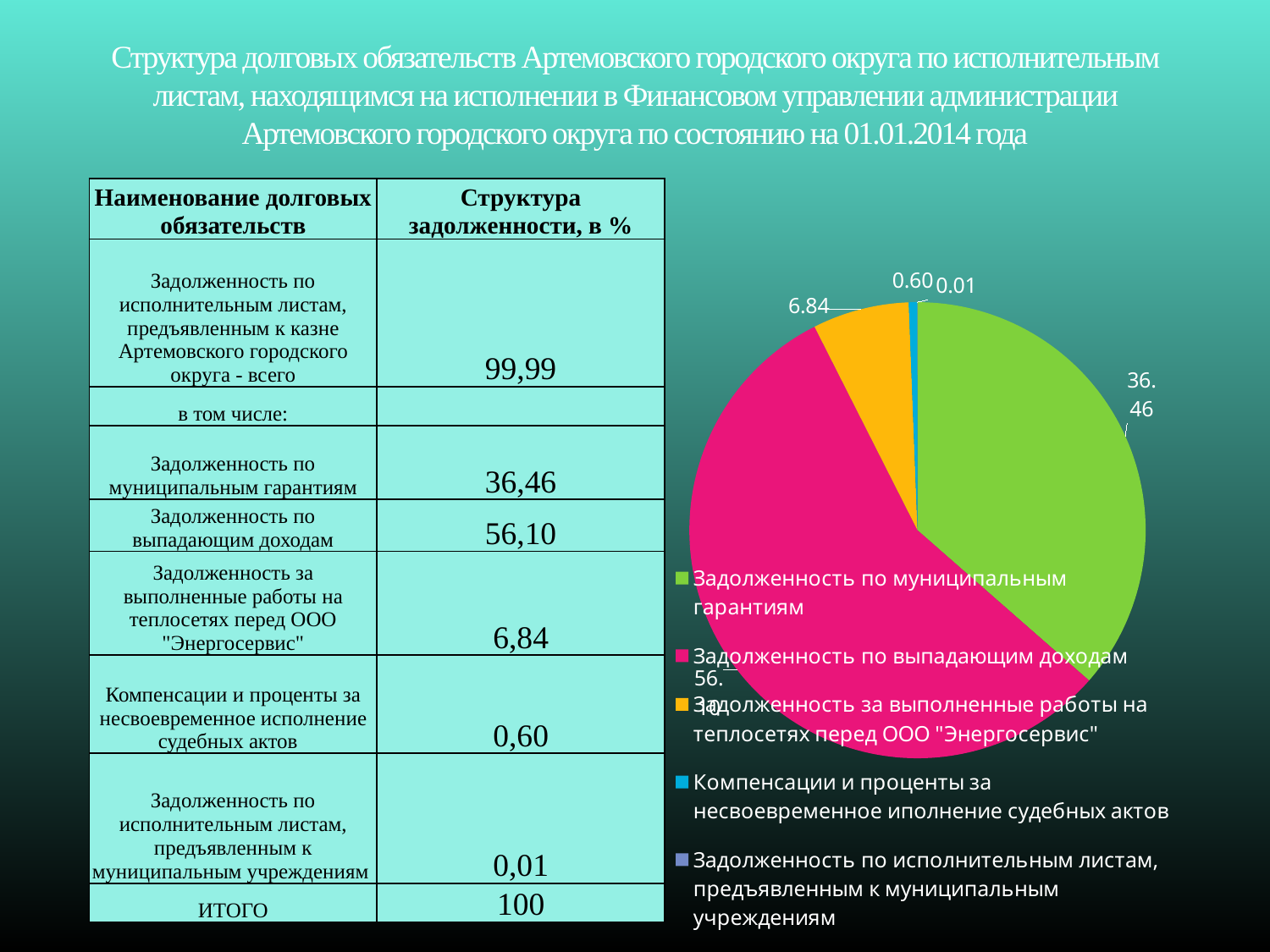
Which category has the smallest slice in the pie chart? Задолженность по исполнительным листам, предъявленным к муниципальным учреждениям How many categories does the pie chart's legend list? 5 What value is labelled on the pie slice for "Компенсации и проценты за несвоевременное иполнение судебных актов"? 0.60 Which slice is larger: "Задолженность по муниципальным гарантиям" or "Задолженность по выпадающим доходам"? Задолженность по выпадающим доходам What is the difference between the values for "Задолженность по выпадающим доходам" (56.10) and "Задолженность по муниципальным гарантиям" (36.46)? 19.64 What value is labelled on the pie slice for "Задолженность за выполненные работы на теплосетях перед ООО "Энергосервис""? 6.84 Which category has the largest slice in the pie chart? Задолженность по выпадающим доходам What colour is the largest slice of the pie chart? pink (magenta) What value is labelled on the pie slice for "Задолженность по исполнительным листам, предъявленным к муниципальным учреждениям"? 0.01 What value is labelled on the pie slice for "Задолженность по муниципальным гарантиям"? 36.46 What kind of chart is shown on the slide? pie chart What is the difference between the values for "Задолженность за выполненные работы на теплосетях перед ООО "Энергосервис"" (6.84) and "Компенсации и проценты за несвоевременное иполнение судебных актов" (0.60)? 6.24